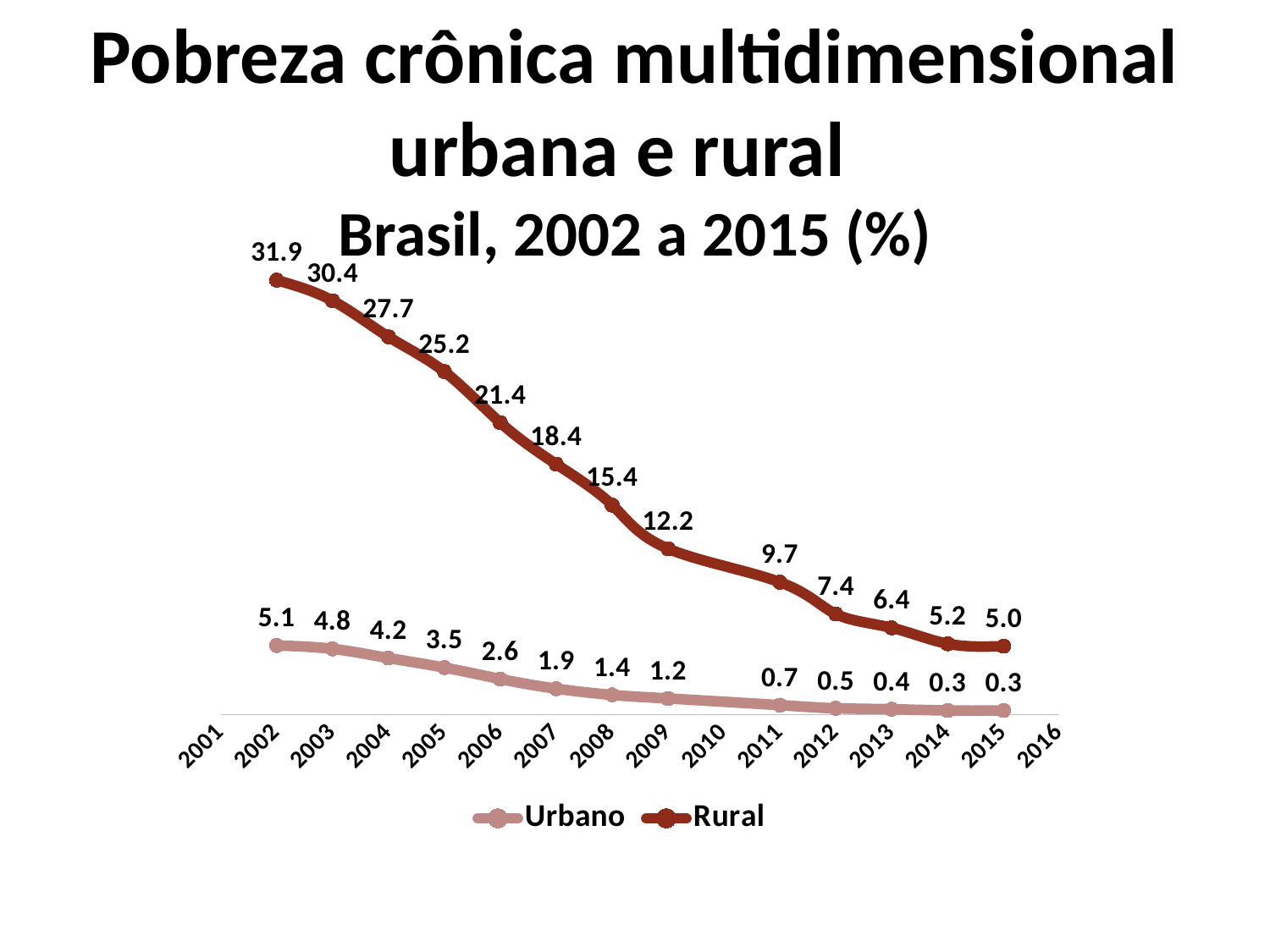
What is the Rural value in 2002? 31.9 In which year is the Rural series at its highest? 2002 What is the Rural value in 2011? 9.7 How many series does the legend list? 2 What is the Urbano value in 2009? 1.2 What is the Urbano value in 2015? 0.3 What kind of chart is shown on the slide? Line chart By how much did the Rural value fall from 2002 to 2015? 26.9 Do the Rural values rise or fall from 2002 to 2015? Fall In which year is the Urbano series at its lowest? 2014 and 2015 What is the difference between the Rural and Urbano values in 2002? 26.8 Which series has the larger value in 2008, Urbano or Rural? Rural